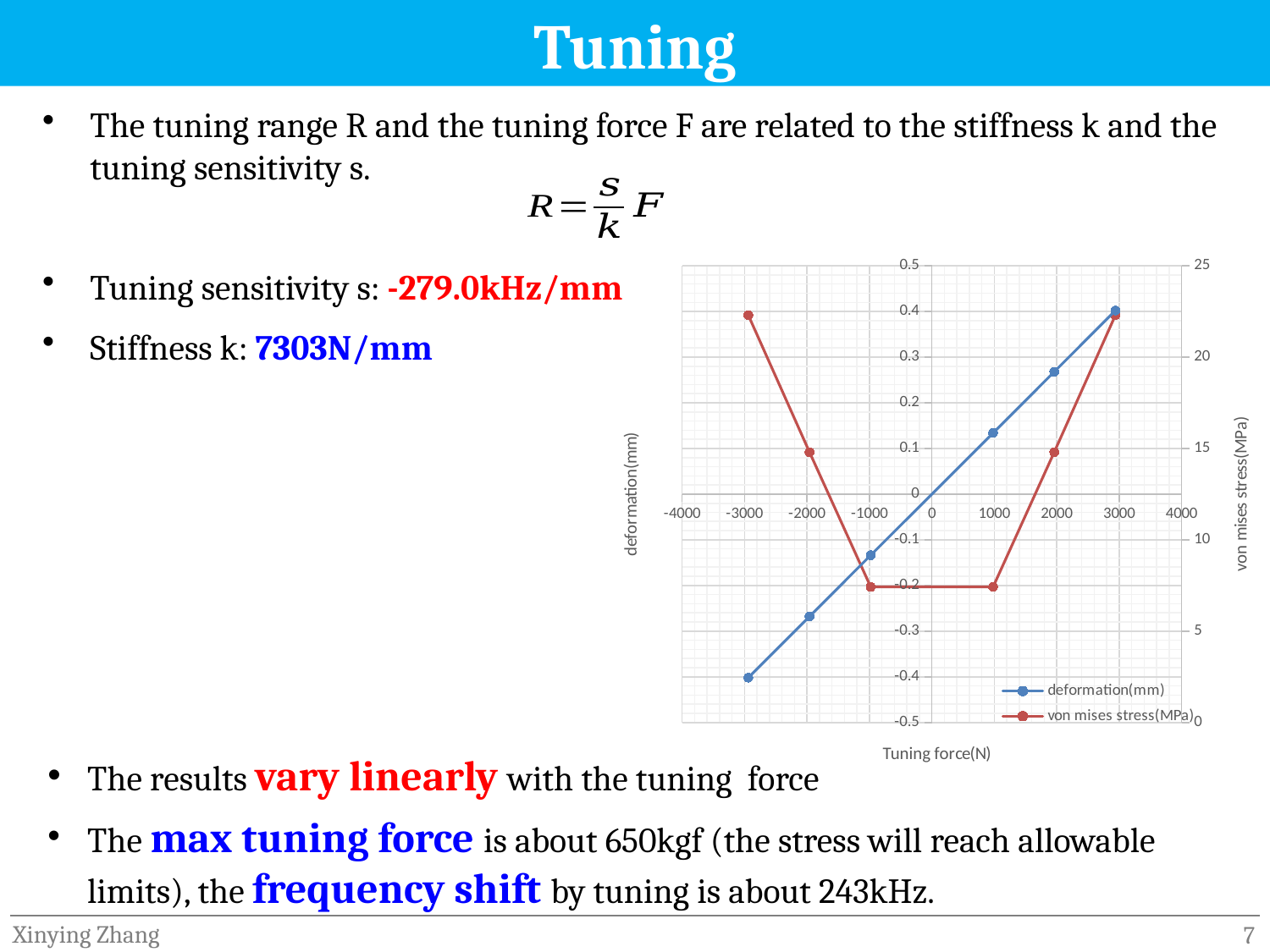
What kind of chart is shown on the slide? line chart How many data points are plotted for the deformation(mm) series? 6 What is the title of the x axis of the chart? Tuning force(N) How many series does the chart legend list? 2 Which is larger, the von mises stress(MPa) at a tuning force of -3000 N or at 1000 N? -3000 N Is the von mises stress(MPa) value at a tuning force of 3000 N greater or less than 20? greater Does the deformation(mm) series rise or fall as the tuning force increases from -3000 N to 3000 N? rise Is the deformation(mm) value at a tuning force of -3000 N greater or less than -0.3? less What is the title of the right-hand y axis of the chart? von mises stress(MPa) Is the deformation(mm) value at a tuning force of 3000 N greater or less than 0.3? greater